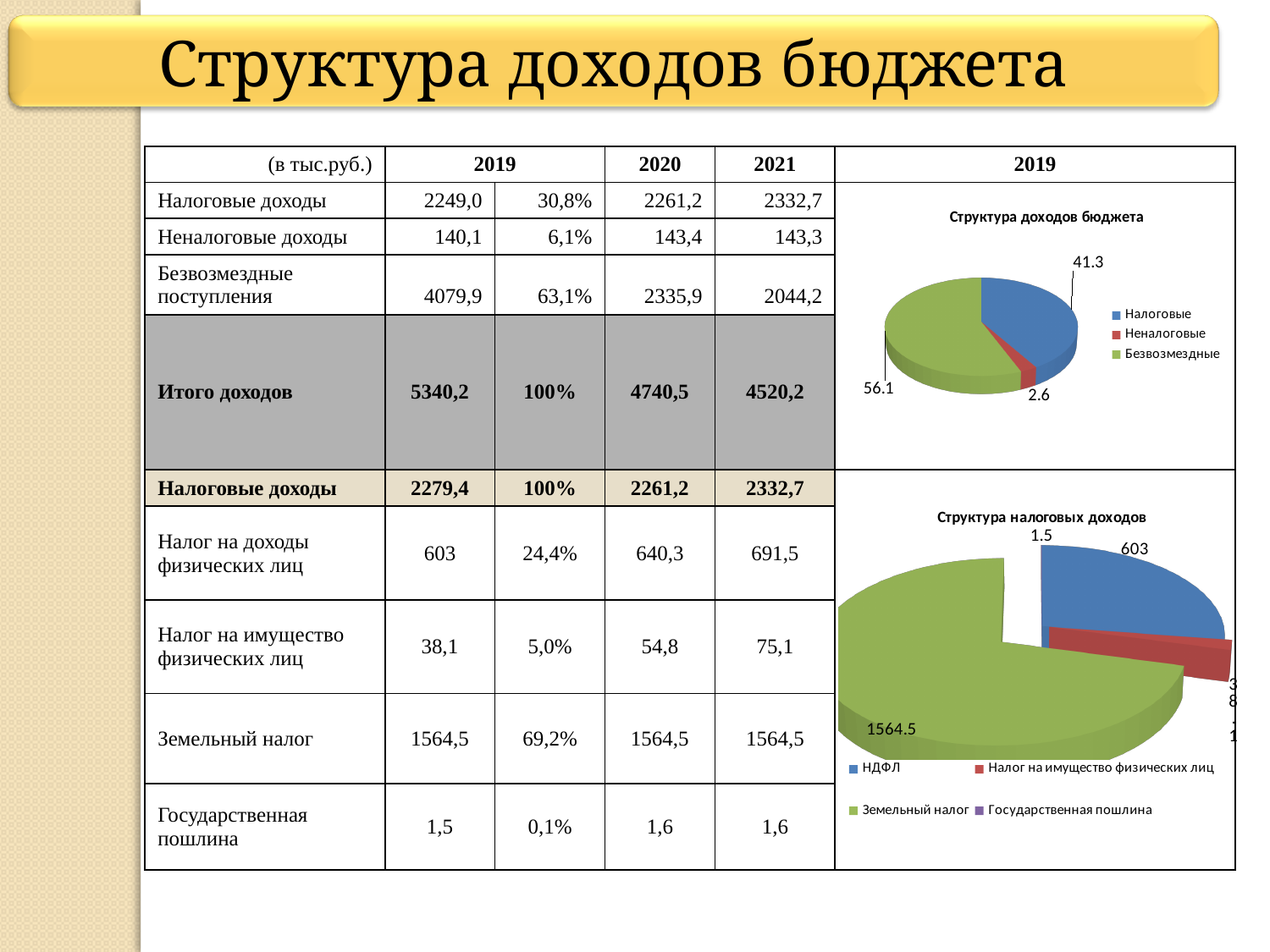
In the bottom pie chart "Структура налоговых доходов", what value is shown for НДФЛ? 603 In the top pie chart "Структура доходов бюджета", what value is shown for the Неналоговые slice? 2.6 What type of chart is the top chart titled "Структура доходов бюджета"? pie chart In the top pie chart "Структура доходов бюджета", what value is shown for the Безвозмездные slice? 56.1 In the top pie chart "Структура доходов бюджета", which category has the smallest slice? Неналоговые In the top pie chart "Структура доходов бюджета", what value is shown for the Налоговые slice? 41.3 In the top pie chart "Структура доходов бюджета", what is the difference between the Безвозмездные value and the Налоговые value? 14.8 In the top pie chart "Структура доходов бюджета", how many categories does the legend list? 3 In the top pie chart "Структура доходов бюджета", which category has the largest slice? Безвозмездные In the bottom pie chart "Структура налоговых доходов", what value is shown for Земельный налог? 1564.5 In the bottom pie chart "Структура налоговых доходов", which category has the largest slice? Земельный налог In the bottom pie chart "Структура налоговых доходов", how many categories does the legend list? 4